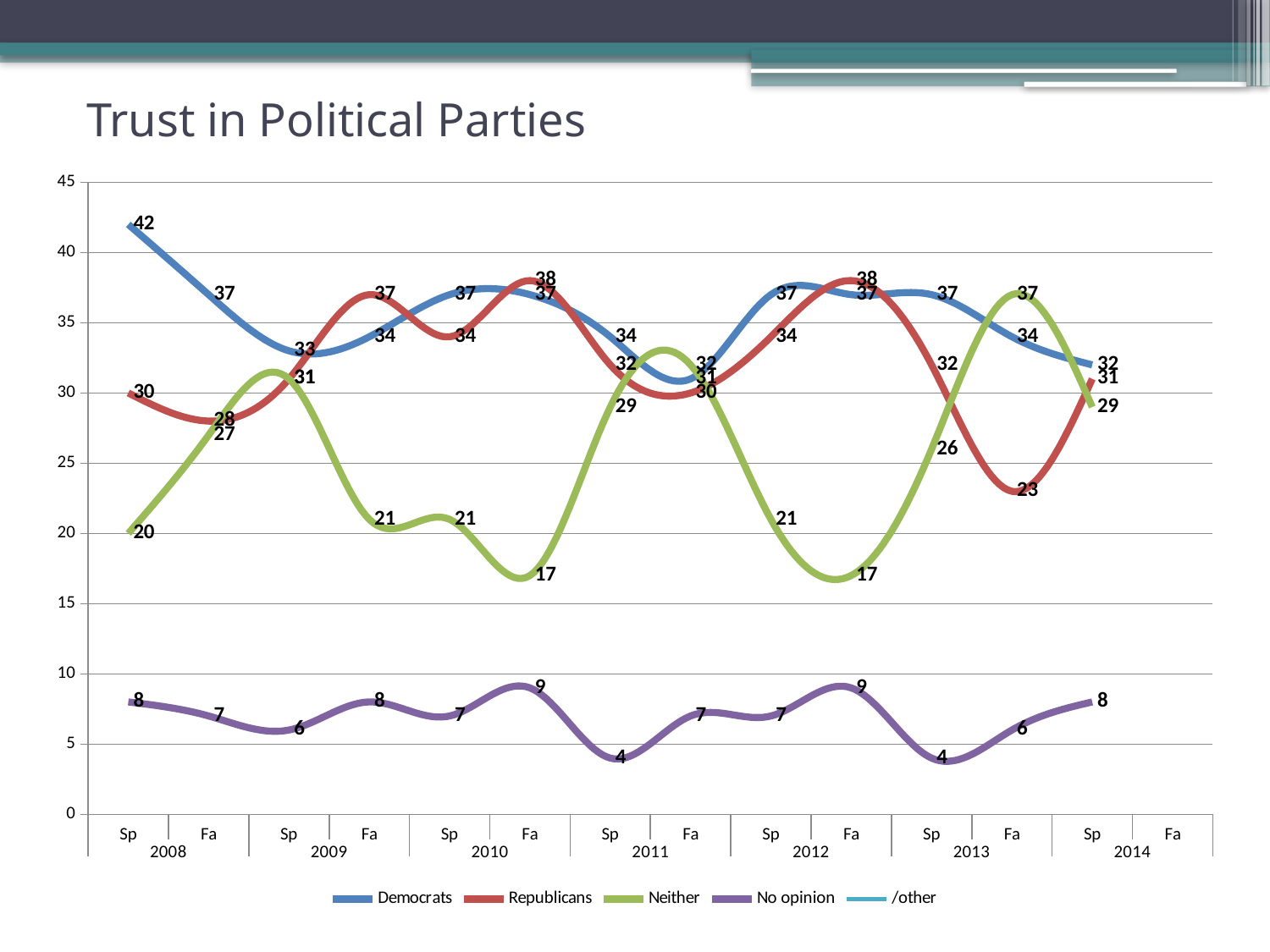
What is the title of the chart? Trust in Political Parties What is the difference between the Democrats and Republicans values in Sp 2008? 12 At which point does the Republicans series reach its lowest value? Fa 2013 Does the Democrats series rise or fall from Sp 2008 to Sp 2009? fall At which point does the Neither series reach its highest value? Fa 2013 What kind of chart is shown on the slide? line chart How many series does the legend list? 5 At which point does the Democrats series reach its highest value? Sp 2008 What is the value for Republicans in Fa 2013? 23 What is the value for Democrats in Sp 2008? 42 What is the value for Neither in Fa 2013? 37 In Fa 2013, which is larger: the Democrats value or the Neither value? Neither